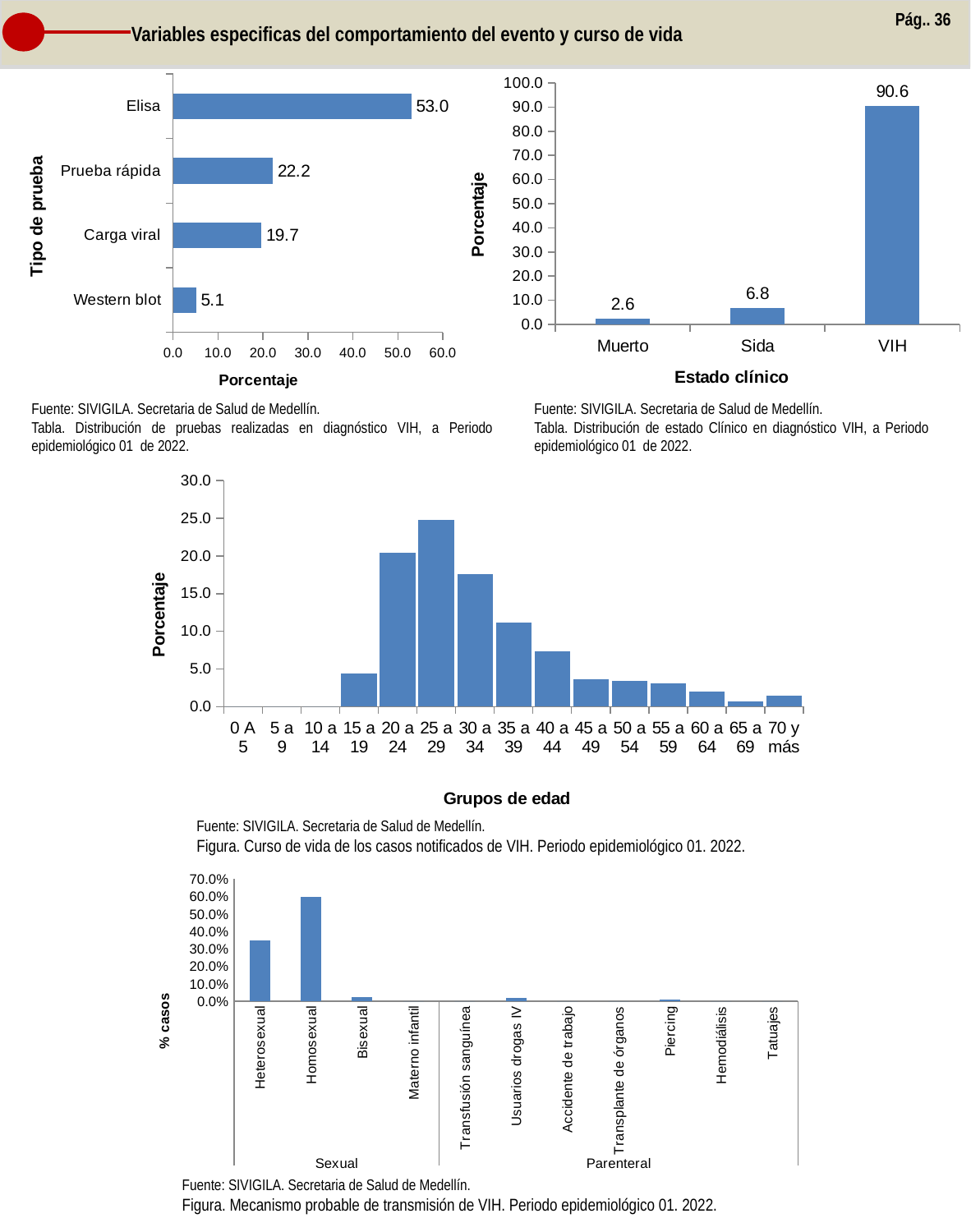
In the top-left chart (Tipo de prueba), what is the difference between Prueba rápida and Carga viral? 2.5 In the top-right chart (Estado clínico), what is the difference between VIH and Sida? 83.8 In the middle chart (Grupos de edad), is the value for 40 a 44 greater or less than 10.0? less In the top-left chart (Tipo de prueba), what kind of chart is shown? Bar chart In the bottom chart (% casos), is the value for Heterosexual greater or less than 40.0%? less In the middle chart (Grupos de edad), which age group has the highest value? 25 a 29 In the top-right chart (Estado clínico), which category has the lowest value? Muerto In the top-left chart (Tipo de prueba), what is the value for Elisa? 53.0 In the middle chart (Grupos de edad), how many age groups are shown on the x axis? 15 In the top-left chart (Tipo de prueba), what is the value for Western blot? 5.1 In the bottom chart (% casos), which category has the highest value? Homosexual In the top-right chart (Estado clínico), what is the value for Sida? 6.8